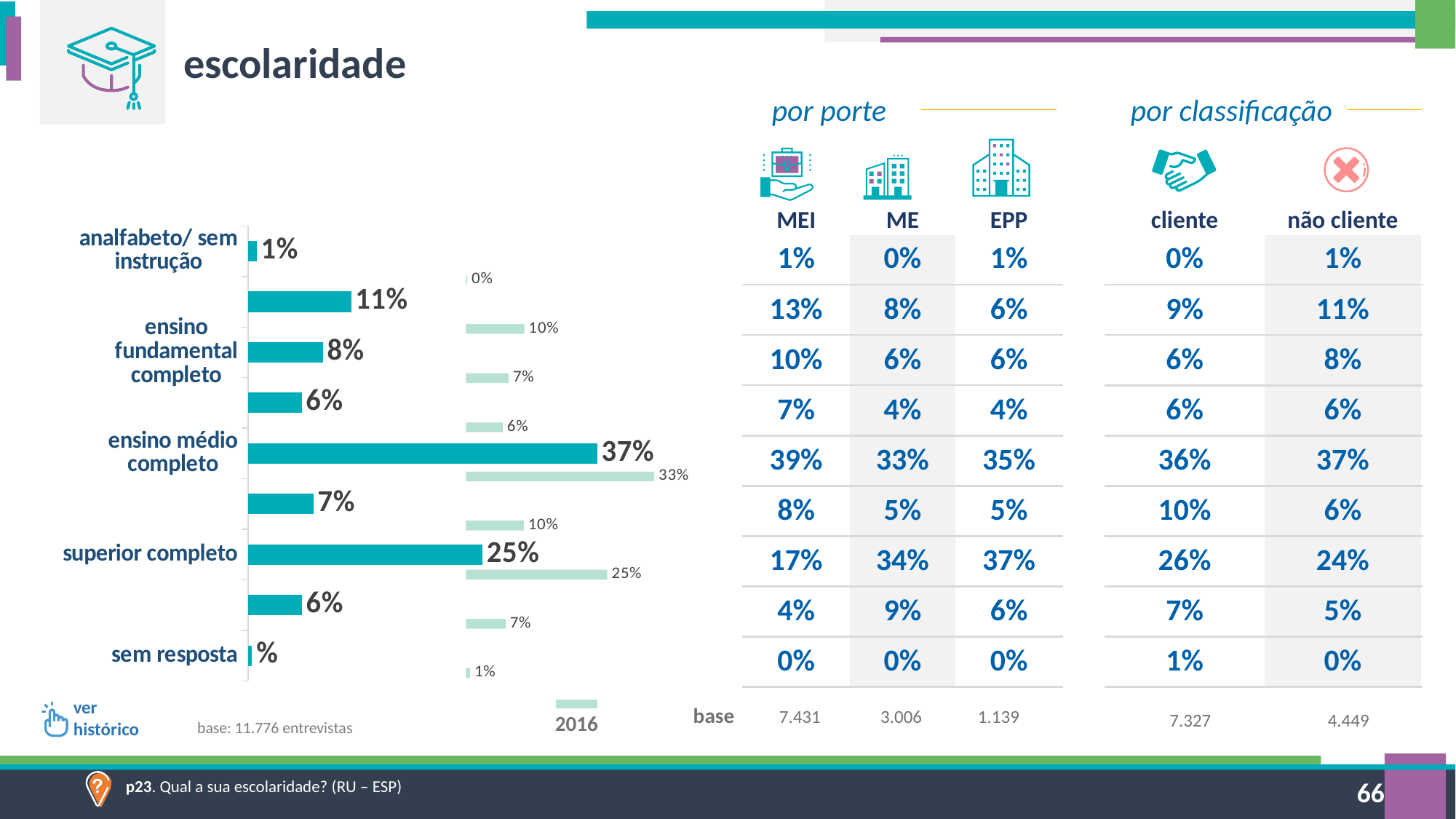
What is the value for 'ensino médio completo' in the bar chart? 37% What is the value for 'analfabeto/ sem instrução' in the bar chart? 1% Which category has the highest value in the bar chart? ensino médio completo Which is larger in the bar chart: 'ensino fundamental completo' or 'superior completo'? superior completo What is the 2016 value shown for 'ensino médio completo' in the bar chart? 33% What is the value for 'ensino fundamental completo' in the bar chart? 8% What is the value for 'superior completo' in the bar chart? 25% What year does the light green comparison series in the bar chart represent? 2016 How many dark teal bars are plotted in the bar chart? 9 What is the difference between the values for 'ensino médio completo' and 'superior completo' in the bar chart? 12 percentage points What kind of chart is shown on the slide? bar chart By how much does the current value for 'ensino médio completo' exceed its 2016 value in the bar chart? 4 percentage points